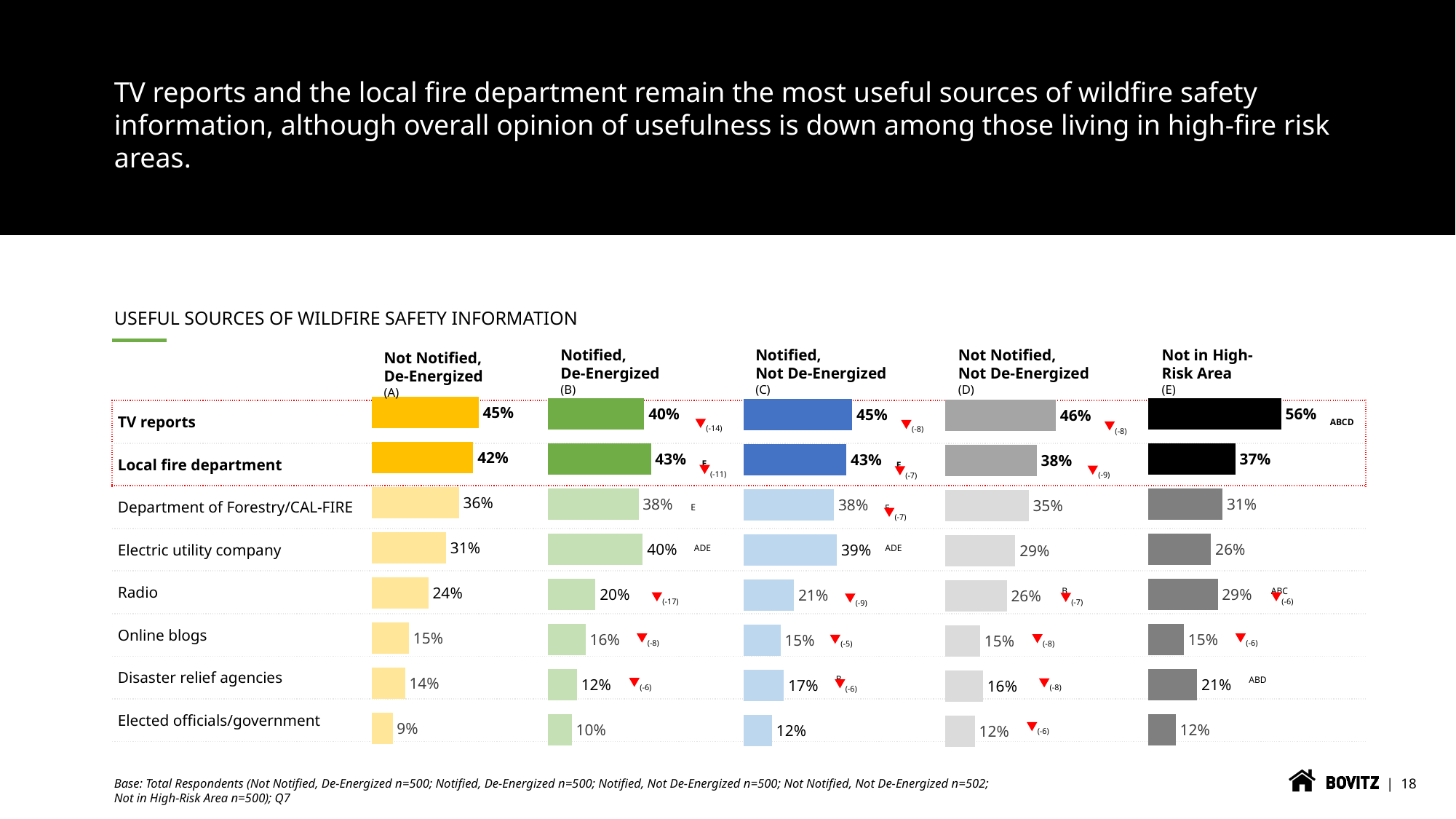
In the "Not in High-Risk Area" chart, what is the difference between TV reports and Local fire department? 19% What kind of chart is used to show the useful sources of wildfire safety information? Bar chart In the "Not Notified, Not De-Energized" chart, which source has the highest percentage? TV reports How many sources of wildfire safety information are listed in each chart? 8 In the "Not in High-Risk Area" chart, what percentage is shown for TV reports? 56% What is the title of the chart section on the slide? USEFUL SOURCES OF WILDFIRE SAFETY INFORMATION In the "Notified, De-Energized" chart, which source has the lowest percentage? Elected officials/government In the "Not Notified, De-Energized" chart, what percentage is shown for Elected officials/government? 9% How many respondent groups (charts) are shown on the slide? 5 In the "Not Notified, De-Energized" chart, what is the difference between Department of Forestry/CAL-FIRE and Electric utility company? 5% In the "Notified, De-Energized" chart, what percentage is shown for Electric utility company? 40% In the "Notified, Not De-Energized" chart, which is larger: Disaster relief agencies or Online blogs? Disaster relief agencies